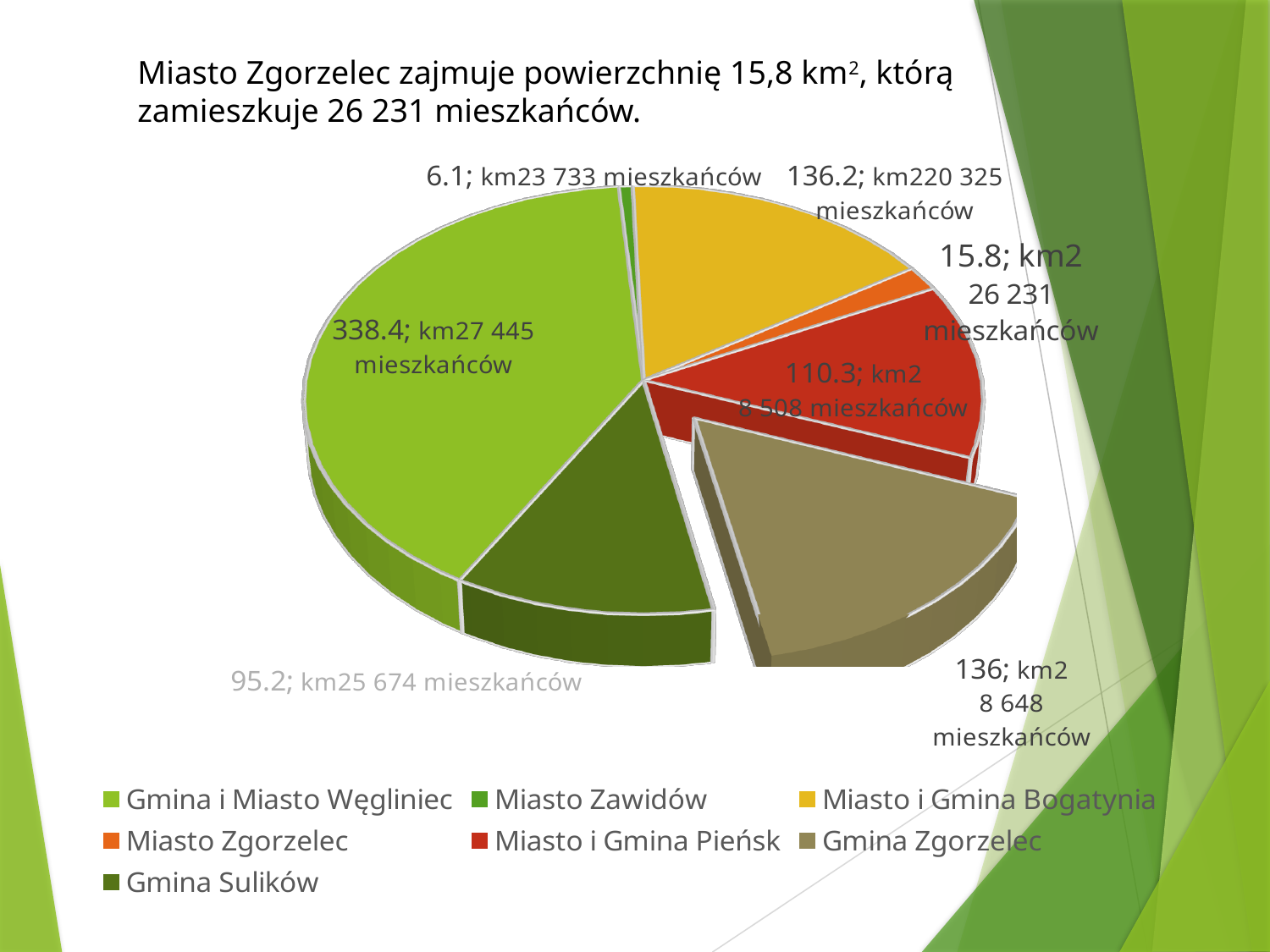
What area in km2 is shown for Miasto i Gmina Pieńsk? 110.3 What area in km2 is shown for Miasto Zawidów? 6.1 Which has the larger area, Miasto i Gmina Pieńsk or Gmina Sulików? Miasto i Gmina Pieńsk Which municipality has the smallest area in the pie chart? Miasto Zawidów What area in km2 is shown for Gmina i Miasto Węgliniec? 338.4 Which municipality has the largest area in the pie chart? Gmina i Miasto Węgliniec What area in km2 is shown for Gmina Sulików? 95.2 What is the difference in area (km2) between Gmina i Miasto Węgliniec and Gmina Sulików? 243.2 How many inhabitants (mieszkańców) are shown for Miasto Zgorzelec? 26 231 What colour is the slice for Miasto i Gmina Bogatynia? yellow What kind of chart is shown on the slide? pie chart How many slices does the pie chart have? 7